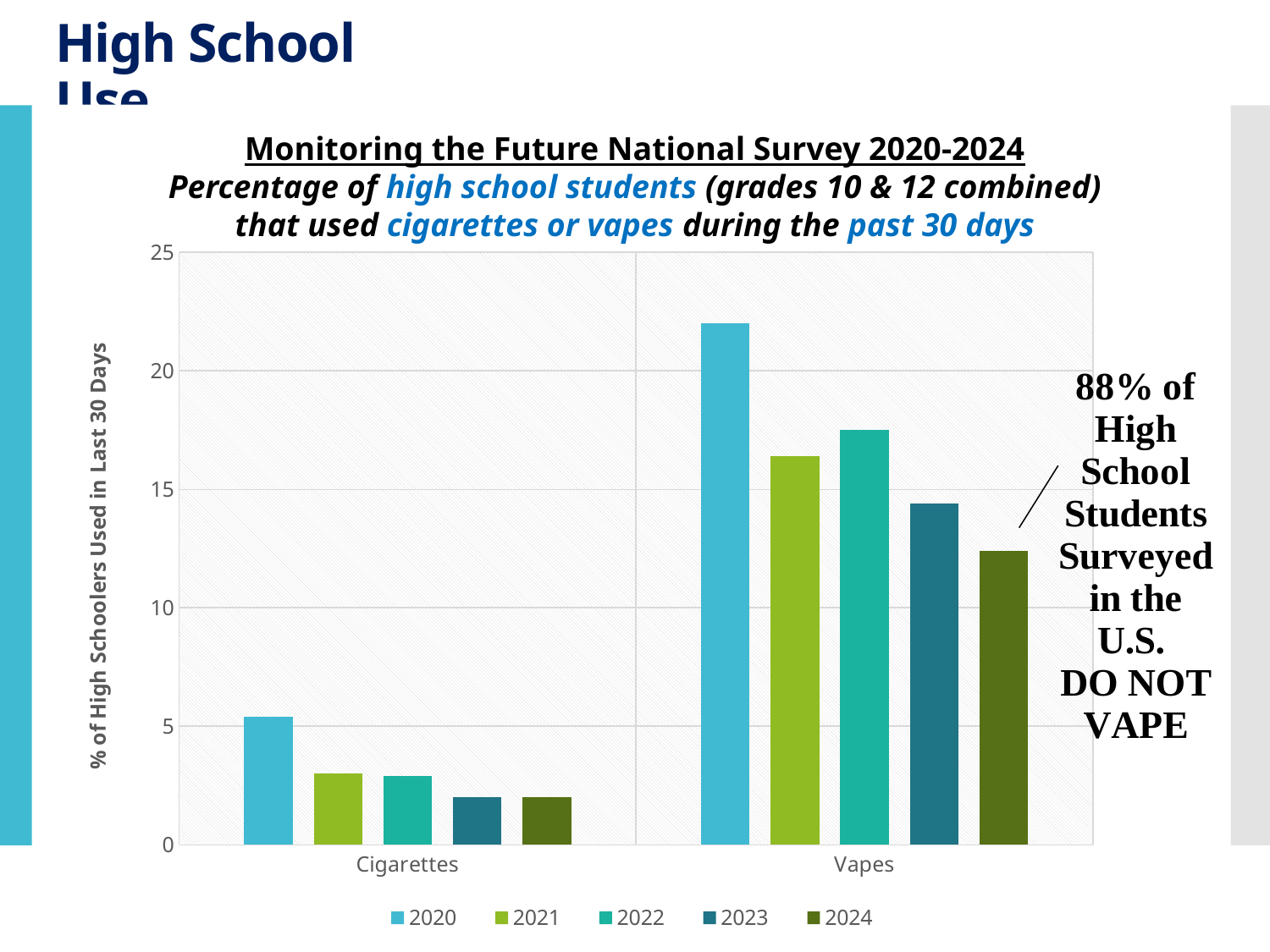
Is the value for Cigarettes in 2020 greater or less than 5? greater What is the label on the vertical axis? % of High Schoolers Used in Last 30 Days Which year has the lowest value for Vapes? 2024 Do the values for Vapes rise or fall from 2022 to 2024? fall Which year has the highest value for Vapes? 2020 Which year has the highest value for Cigarettes? 2020 Is the value for Vapes in 2020 greater or less than 20? greater How many series does the legend list? 5 What kind of chart is shown on the slide? bar chart Which is larger, the value for Vapes in 2023 or the value for Vapes in 2020? Vapes in 2020 Is the value for Vapes in 2024 greater or less than 15? less How many categories are shown on the x axis? 2